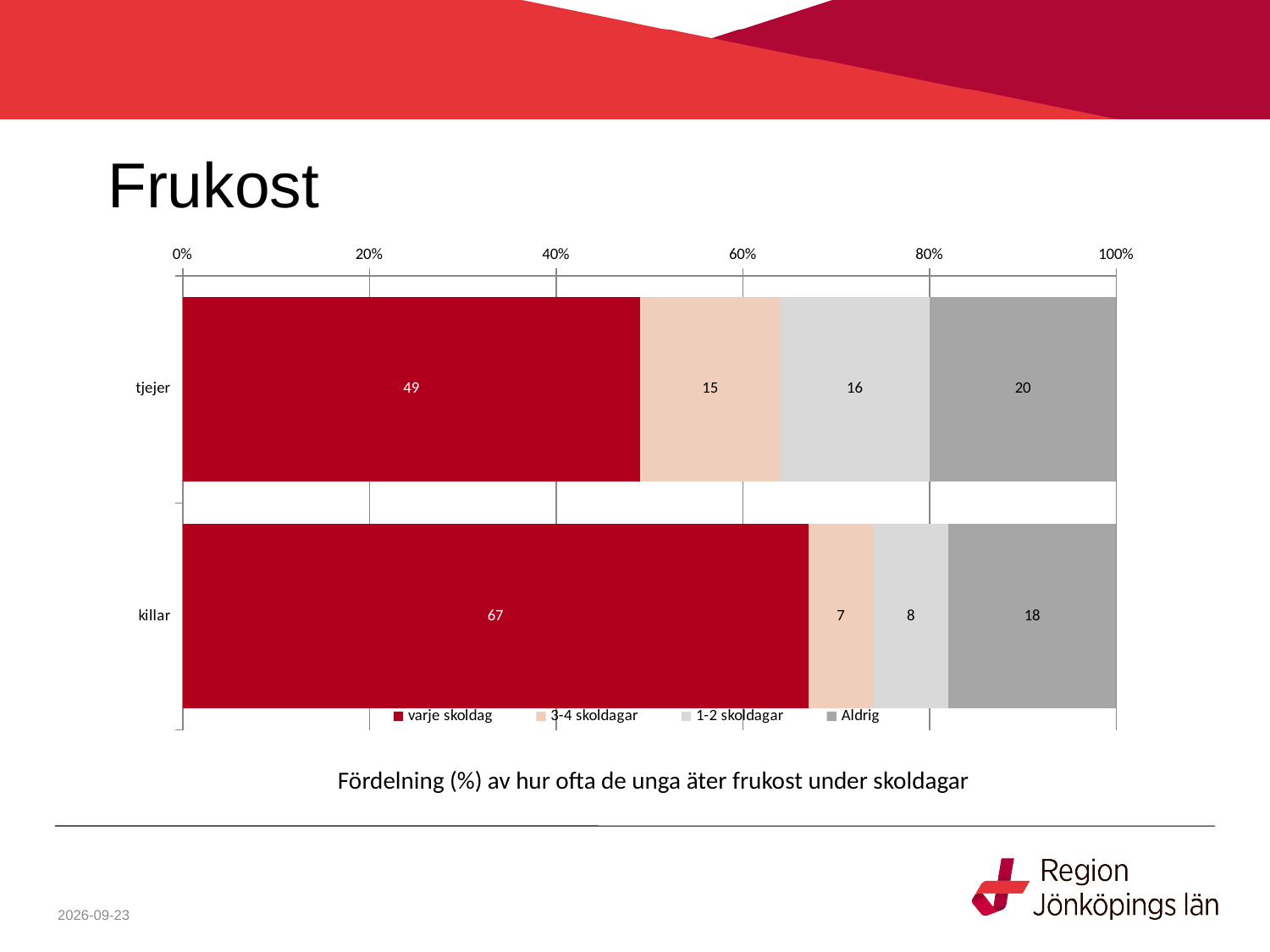
What is the value for '3-4 skoldagar' for killar? 7 Which series has the lowest value for killar? 3-4 skoldagar What kind of chart is shown on the slide? Stacked bar chart What is the difference between the '1-2 skoldagar' values for tjejer and killar? 8 How many series does the legend list? 4 What is the value for 'varje skoldag' for tjejer? 49 Which category has the higher value for 'varje skoldag', tjejer or killar? killar What is the value for '1-2 skoldagar' for tjejer? 16 What is the total of the stacked bar for tjejer? 100 What is the difference between the 'varje skoldag' values for killar and tjejer? 18 How many categories are shown on the chart? 2 What is the value for 'Aldrig' for killar? 18